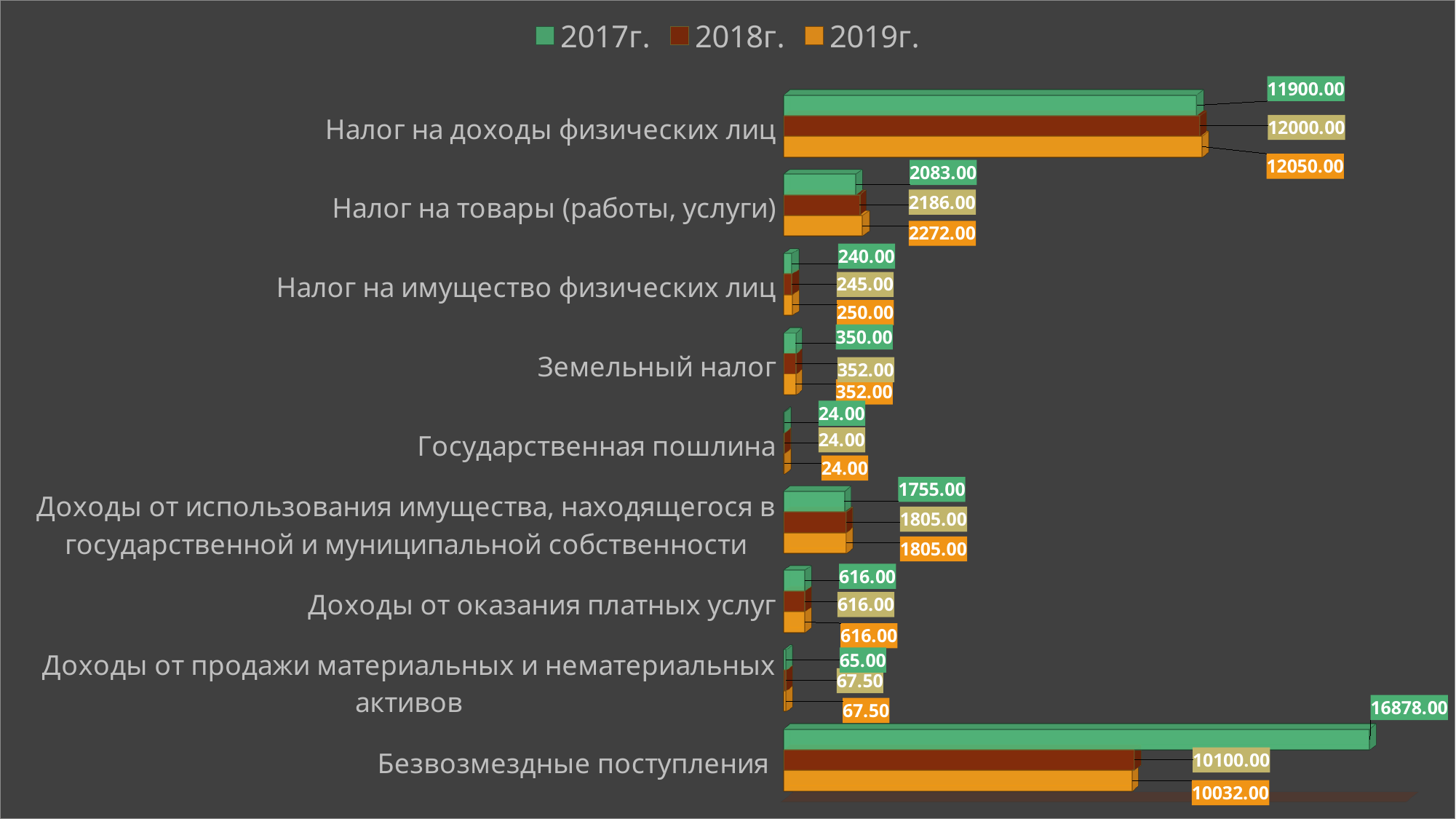
Which is larger for Налог на доходы физических лиц: the 2017г. value or the 2019г. value? 2019г. What type of chart is shown on the slide? bar chart Which category has the highest value in the 2017г. series? Безвозмездные поступления How many series does the legend list? 3 What is the value for Доходы от продажи материальных и нематериальных активов in 2017г.? 65.00 Which category has the lowest value in the 2019г. series? Государственная пошлина How many categories are shown on the chart? 9 What is the value for Налог на товары (работы, услуги) in 2018г.? 2186.00 What is the value for Безвозмездные поступления in 2017г.? 16878.00 What is the value for Налог на доходы физических лиц in 2019г.? 12050.00 What is the difference between the 2017г. and 2019г. values for Безвозмездные поступления? 6846.00 Which series is shown in green in the legend? 2017г.